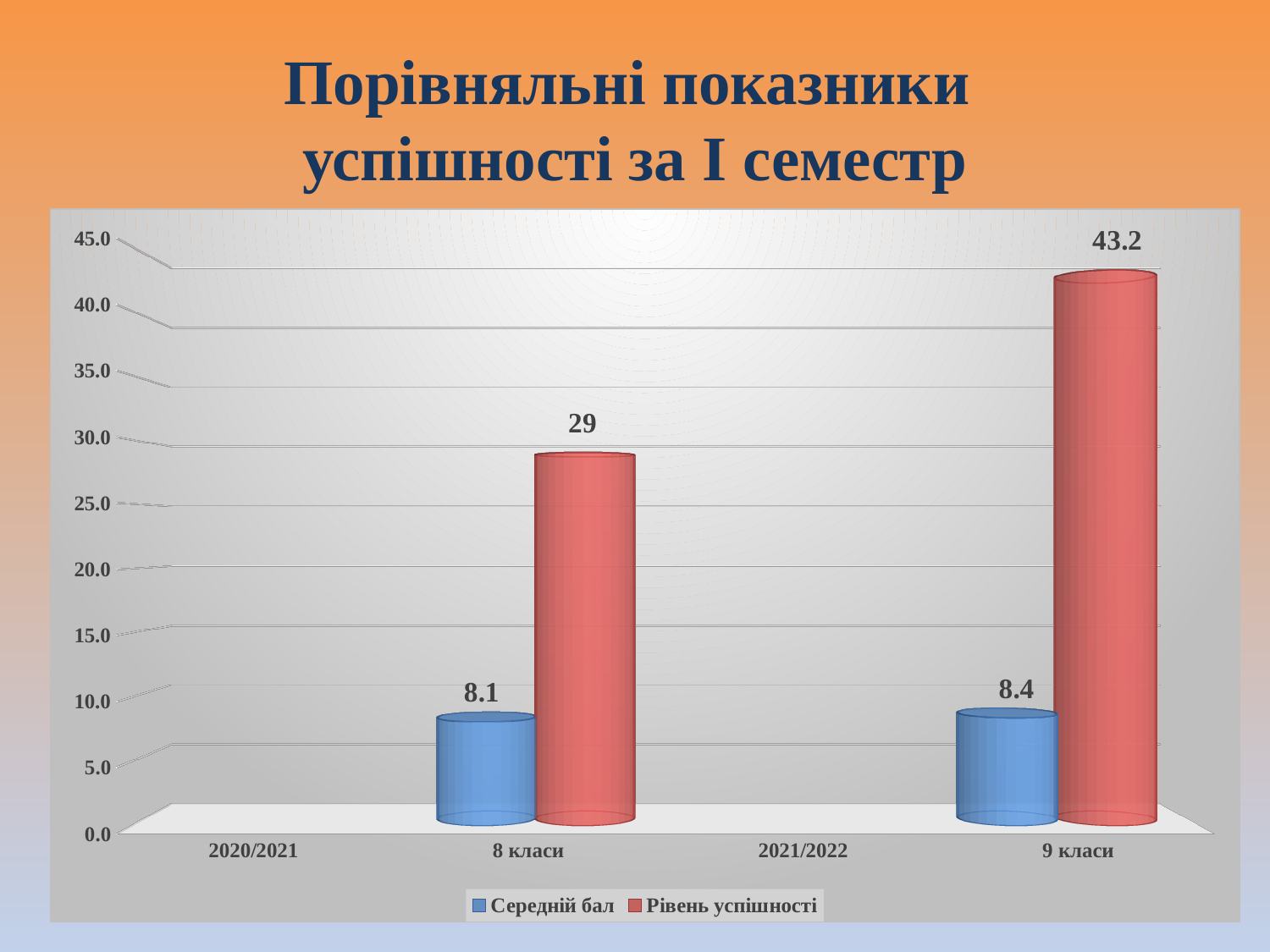
What is the value of Середній бал for 8 класи? 8.1 What is the difference in Середній бал between 9 класи and 8 класи? 0.3 What colour are the Середній бал bars? blue Is the value of Рівень успішності for 9 класи greater or less than 40.0? greater What is the value of Середній бал for 9 класи? 8.4 Which category has the highest Рівень успішності? 9 класи Which is larger: Рівень успішності for 8 класи or for 9 класи? 9 класи What is the difference in Рівень успішності between 9 класи and 8 класи? 14.2 What is the value of Рівень успішності for 8 класи? 29 What kind of chart is shown on the slide? bar chart What is the value of Рівень успішності for 9 класи? 43.2 How many series does the legend list? 2